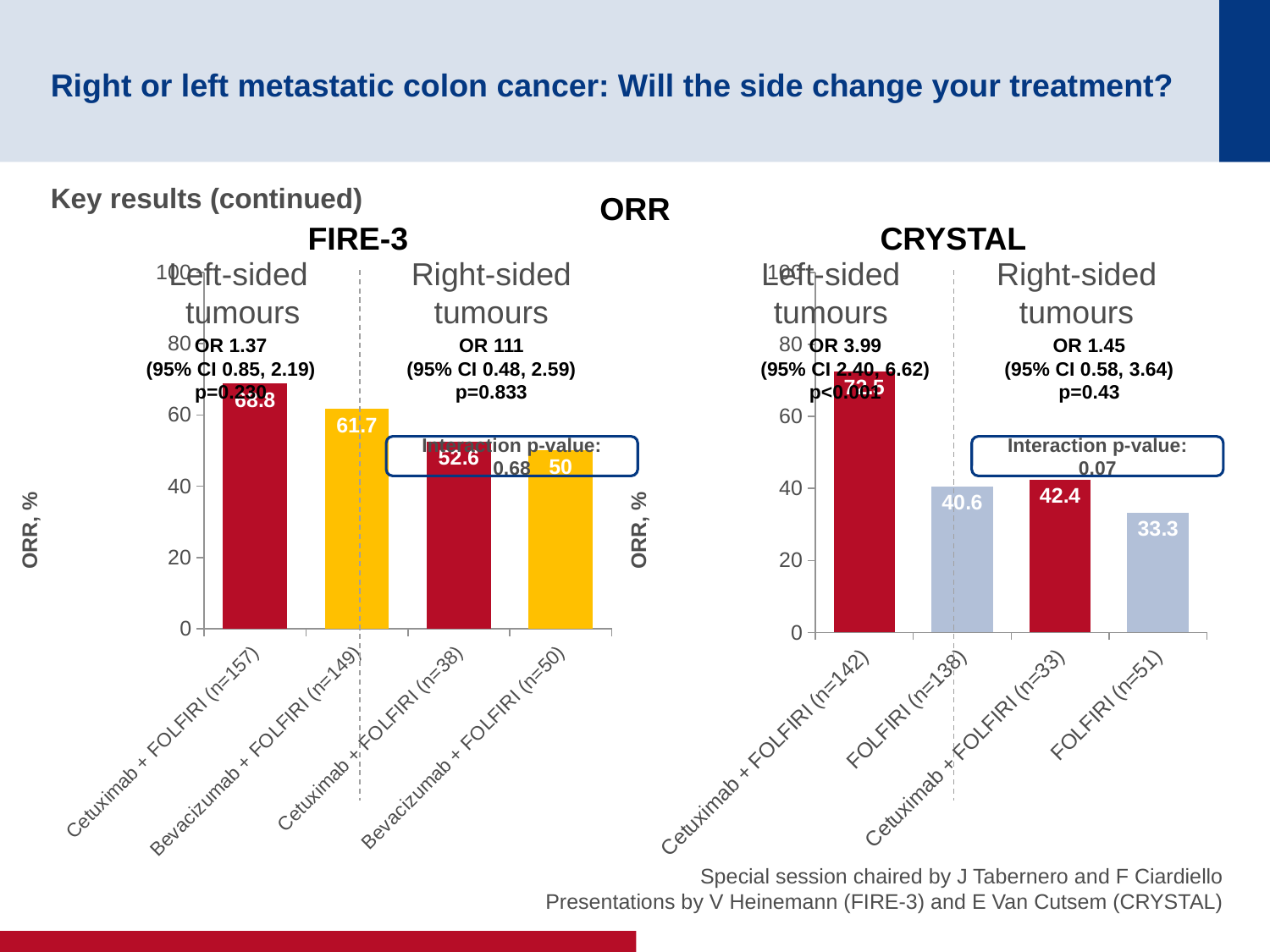
In the CRYSTAL chart, what is the ORR for FOLFIRI (n=138)? 40.6 In the FIRE-3 chart, what is the ORR for Bevacizumab + FOLFIRI (n=149)? 61.7 In the FIRE-3 chart, what is the ORR for Cetuximab + FOLFIRI (n=157)? 68.8 In the CRYSTAL chart, what is the difference in ORR between Cetuximab + FOLFIRI (n=33) and FOLFIRI (n=51)? 9.1 In the FIRE-3 chart, which has a higher ORR: Cetuximab + FOLFIRI (n=157) or Bevacizumab + FOLFIRI (n=149)? Cetuximab + FOLFIRI (n=157) How many bars are shown in the CRYSTAL chart? 4 In the CRYSTAL chart, what is the ORR for FOLFIRI (n=51)? 33.3 In the CRYSTAL chart, which bar has the lowest ORR? FOLFIRI (n=51) In the FIRE-3 chart, what is the difference in ORR between Cetuximab + FOLFIRI (n=38) and Bevacizumab + FOLFIRI (n=50)? 2.6 In the FIRE-3 chart, which bar has the highest ORR? Cetuximab + FOLFIRI (n=157) In the FIRE-3 chart, what is the ORR for Bevacizumab + FOLFIRI (n=50)? 50 What type of chart is used for the FIRE-3 results? Bar chart